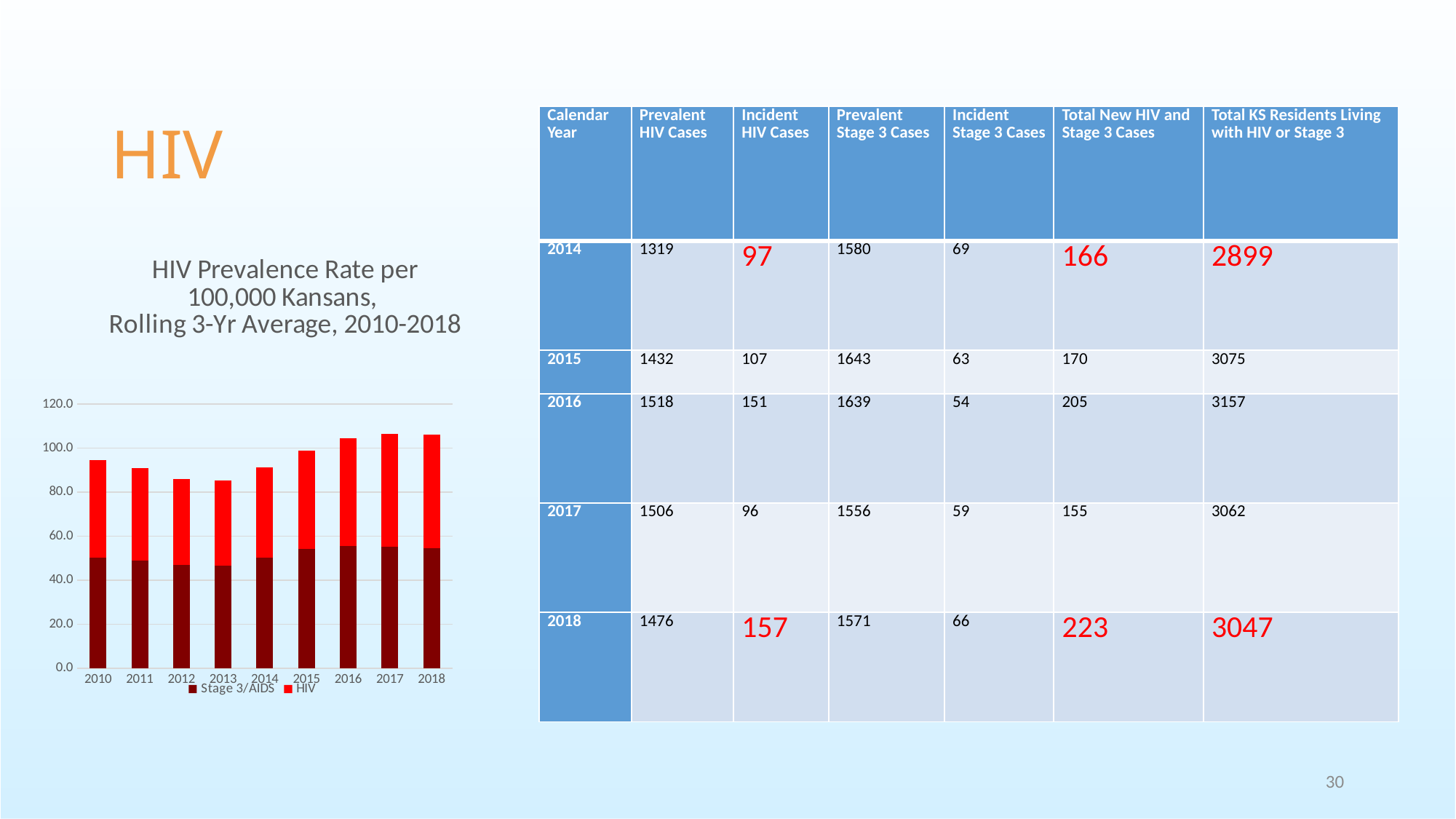
From 2013 to 2017, do the total bar heights rise or fall? rise What kind of chart is shown on the slide? Stacked bar chart How many years are shown on the x axis of the HIV Prevalence Rate chart? 9 How many series does the legend of the HIV Prevalence Rate chart list? 2 Is the total bar height for 2017 greater or less than 100? greater What is the title of the chart on the slide? HIV Prevalence Rate per 100,000 Kansans, Rolling 3-Yr Average, 2010-2018 Which has a taller total bar, 2010 or 2013? 2010 Is the Stage 3/AIDS value for 2016 greater or less than 60? less Is the total bar height for 2014 greater or less than 100? less Which has a taller total bar, 2014 or 2018? 2018 What are the two series named in the legend of the chart? Stage 3/AIDS and HIV